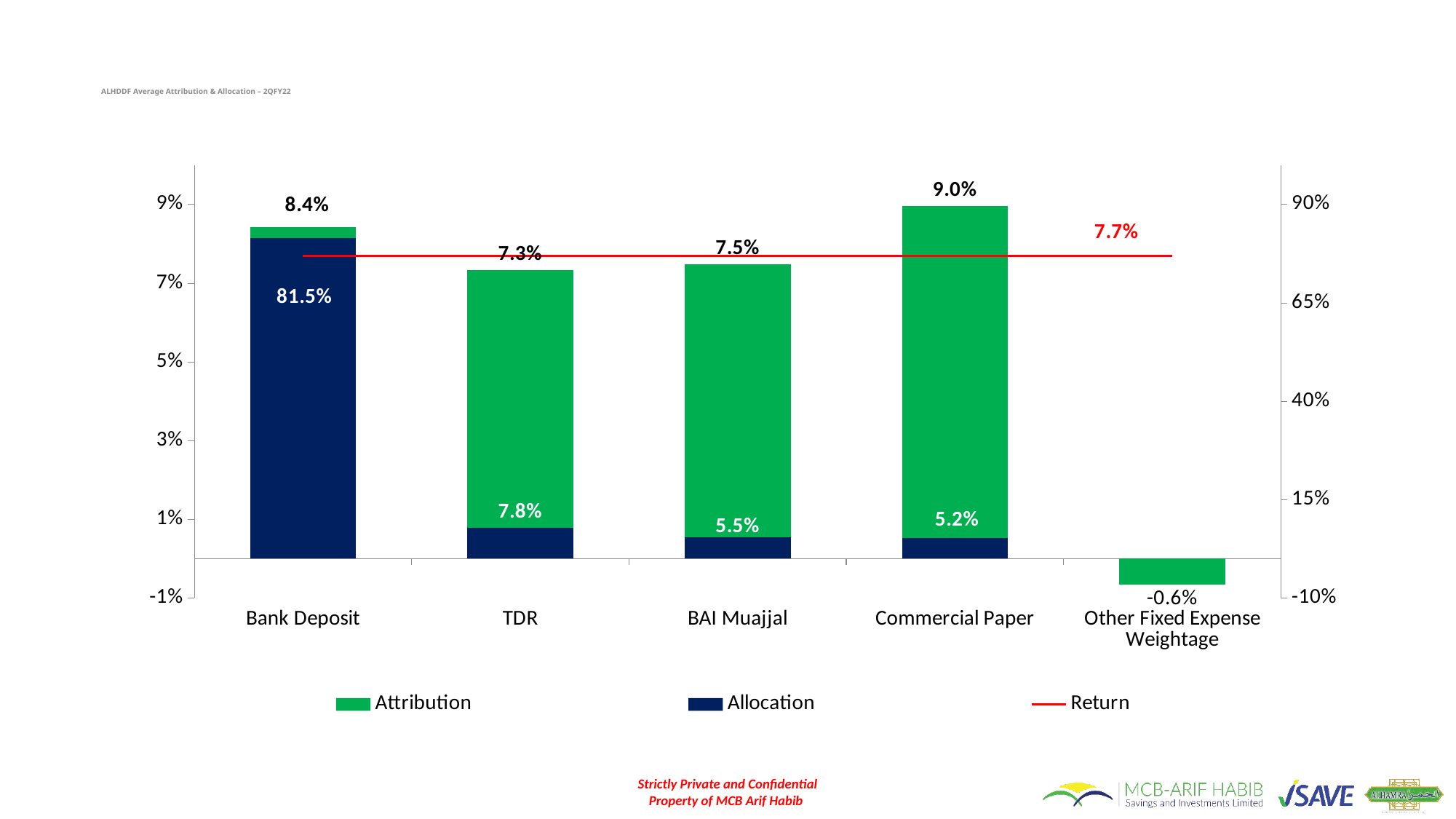
What is the Allocation value for Bank Deposit? 81.5% Which category has the lowest Allocation value among those labelled? Commercial Paper How many series does the legend list? 3 What is the difference between the Attribution values for Commercial Paper and TDR? 1.7% What is the Allocation value for BAI Muajjal? 5.5% What is the title of the chart? ALHDDF Average Attribution & Allocation – 2QFY22 How many categories are shown on the x axis? 5 What is the Attribution value for Other Fixed Expense Weightage? -0.6% Which is larger, the Attribution value for BAI Muajjal or for TDR? BAI Muajjal What is the Attribution value for Commercial Paper? 9.0% What value is shown for the Return line? 7.7% Which category has the highest Attribution value? Commercial Paper